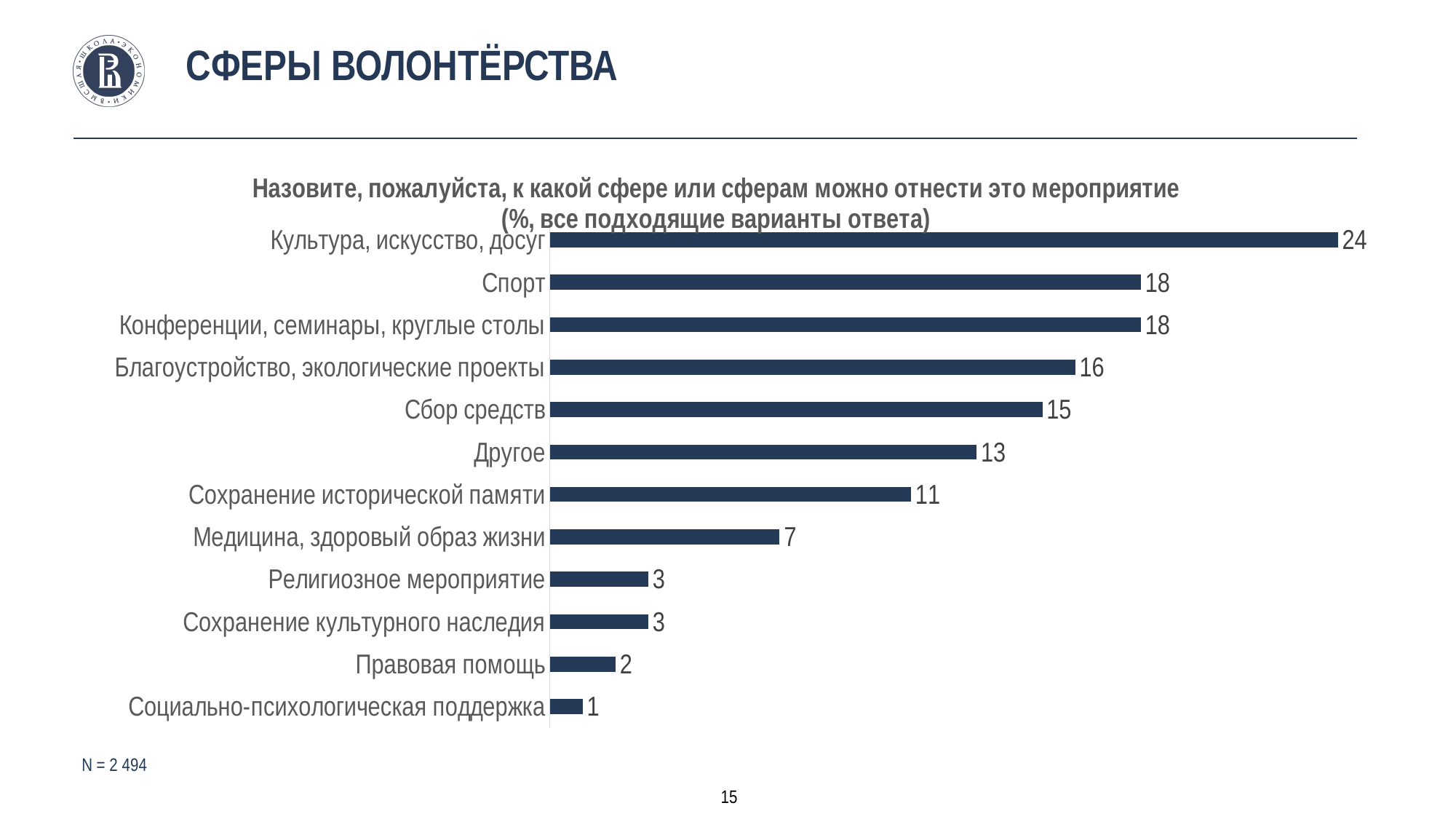
What is the value for Правовая помощь? 2 Which category has the highest value? Культура, искусство, досуг What is the difference between the values for Культура, искусство, досуг and Спорт? 6 Which is larger: the value for Другое or the value for Сбор средств? Сбор средств What sample size (N) is stated on the slide? N = 2 494 How many categories are shown in the chart? 12 Which category has the lowest value? Социально-психологическая поддержка What kind of chart is shown on the slide? Bar chart What is the difference between the values for Благоустройство, экологические проекты and Сохранение исторической памяти? 5 What is the value for Медицина, здоровый образ жизни? 7 What is the value for Сбор средств? 15 What is the value for Культура, искусство, досуг? 24